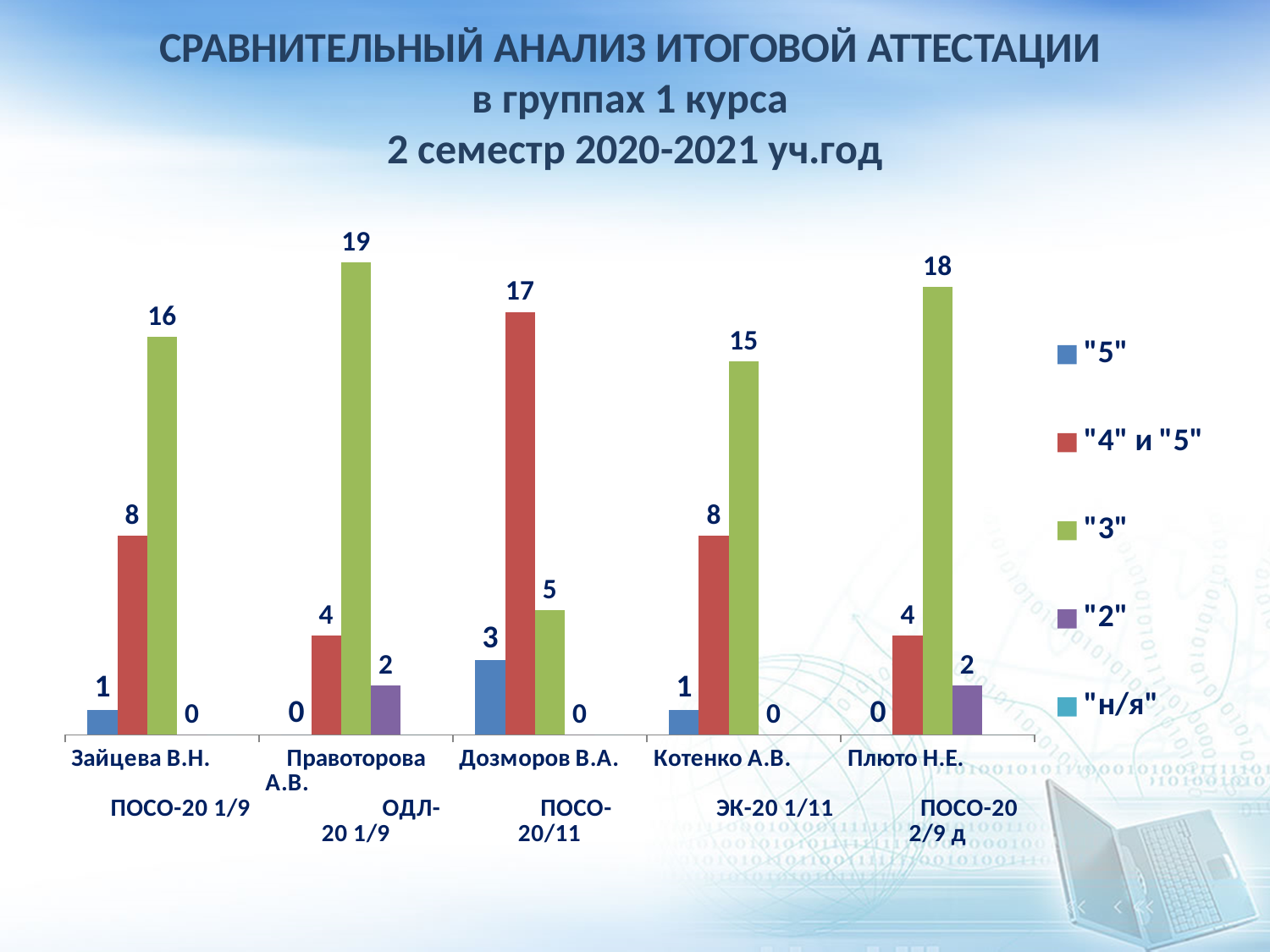
What is the value of the "3" series for Правоторова А.В. (ОДЛ-20 1/9)? 19 What type of chart is shown on the slide? bar chart What is the difference between the "3" values for Правоторова А.В. and Зайцева В.Н.? 3 What is the value of the "5" series for Дозморов В.А. (ПОСО-20/11)? 3 How many teacher/group categories are shown on the x axis? 5 What is the value of the "4" и "5" series for Дозморов В.А. (ПОСО-20/11)? 17 Which is larger: the "4" и "5" value for Котенко А.В. or for Плюто Н.Е.? Котенко А.В. Which category has the lowest value in the "3" series? Дозморов В.А. How many series does the legend list? 5 Which category has the highest value in the "3" series? Правоторова А.В. What is the value of the "2" series for Плюто Н.Е. (ПОСО-20 2/9 д)? 2 What is the total of the "5", "4" и "5", "3" and "2" values for Зайцева В.Н.? 25